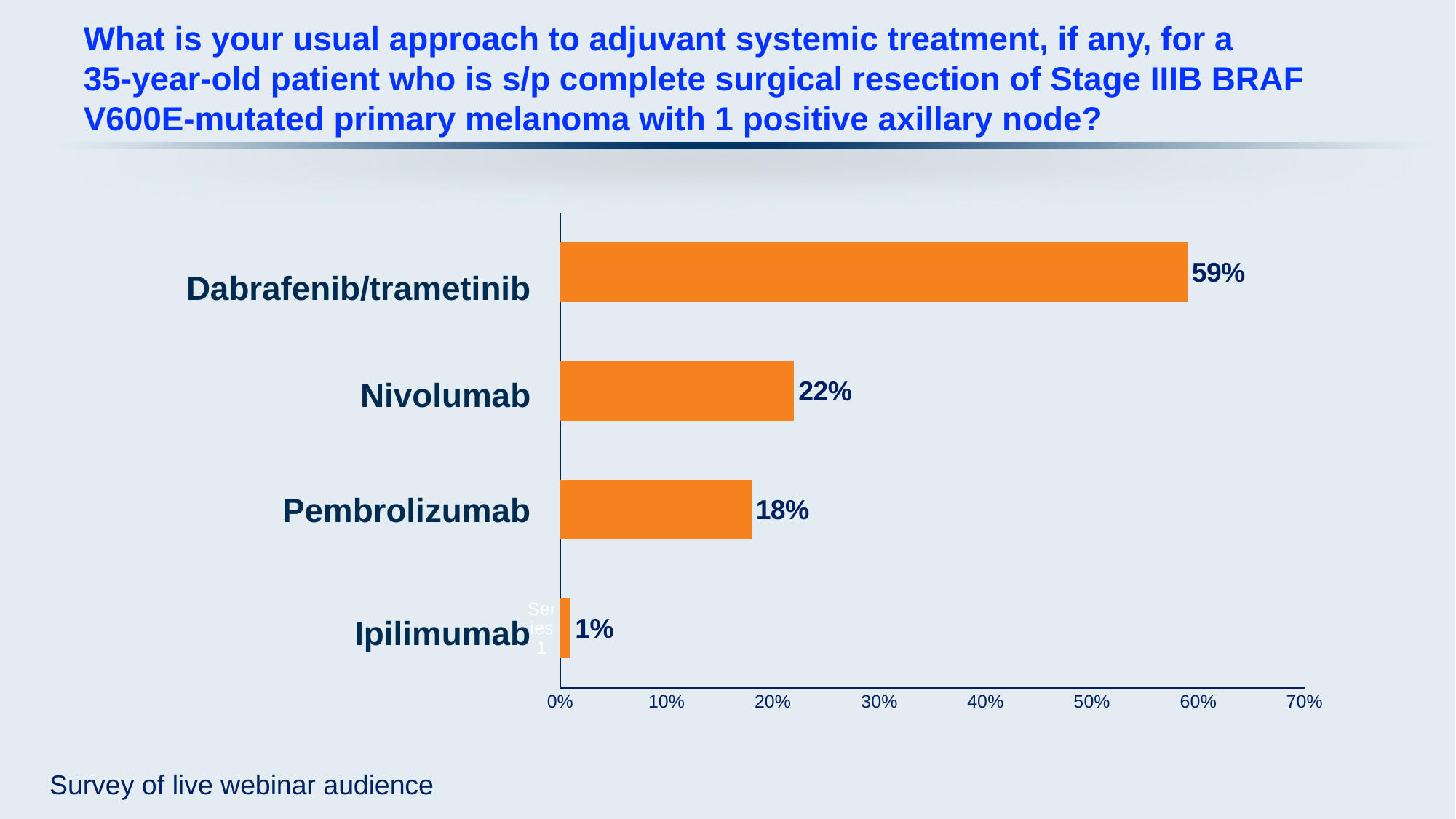
Which received a larger share of responses, Nivolumab or Pembrolizumab? Nivolumab Is the value for Dabrafenib/trametinib greater or less than 50%? greater Which treatment option received the highest share of responses? Dabrafenib/trametinib What percentage of respondents chose Dabrafenib/trametinib? 59% What percentage of respondents chose Ipilimumab? 1% What type of chart is shown on the slide? Bar chart What percentage of respondents chose Nivolumab? 22% What percentage of respondents chose Pembrolizumab? 18% What is the difference in percentage points between Nivolumab and Pembrolizumab? 4 Which treatment option received the lowest share of responses? Ipilimumab What is the difference in percentage points between Dabrafenib/trametinib and Nivolumab? 37 How many treatment options are shown in the chart? 4